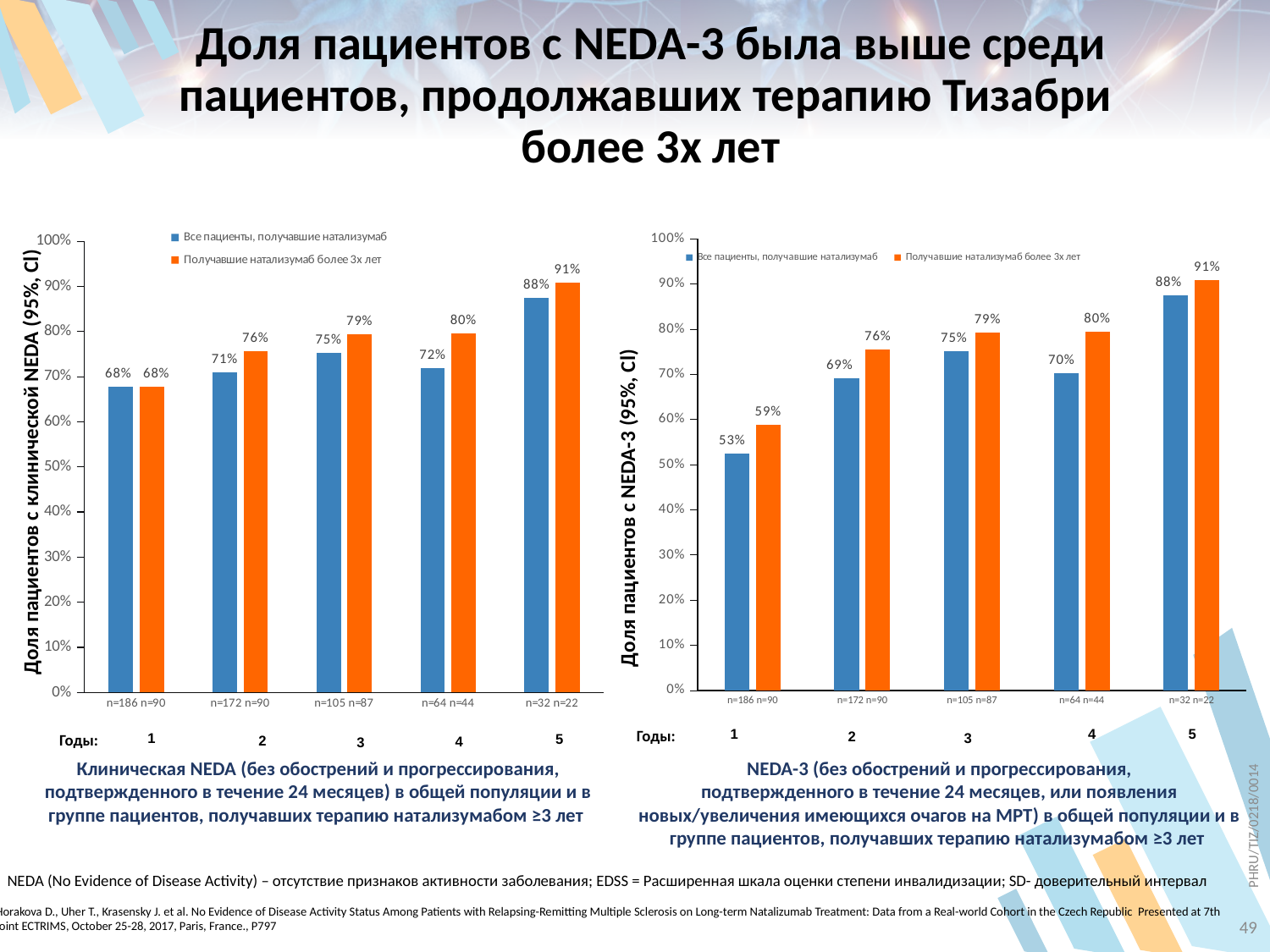
In the left chart, what is the value for all patients receiving natalizumab in year 1? 68% How many series does the legend of the right chart list? 2 In the right chart, what is the value for patients receiving natalizumab for more than 3 years in year 2? 76% In the right chart, what is the value for all patients receiving natalizumab in year 1? 53% In the right chart, what is the difference between the two series in year 1? 6% In the left chart, what is the difference between the value for patients treated more than 3 years and all patients in year 4? 8% What type of chart is the left chart? Bar chart In the left chart, which is larger in year 3: the value for all patients or for patients treated more than 3 years? Patients treated more than 3 years In the left chart, which year has the highest value for patients receiving natalizumab for more than 3 years? 5 In the right chart, is the value for all patients in year 1 greater or less than 60%? less In the right chart, which year has the lowest value for all patients receiving natalizumab? 1 How many years (categories) are shown on the x axis of the left chart? 5